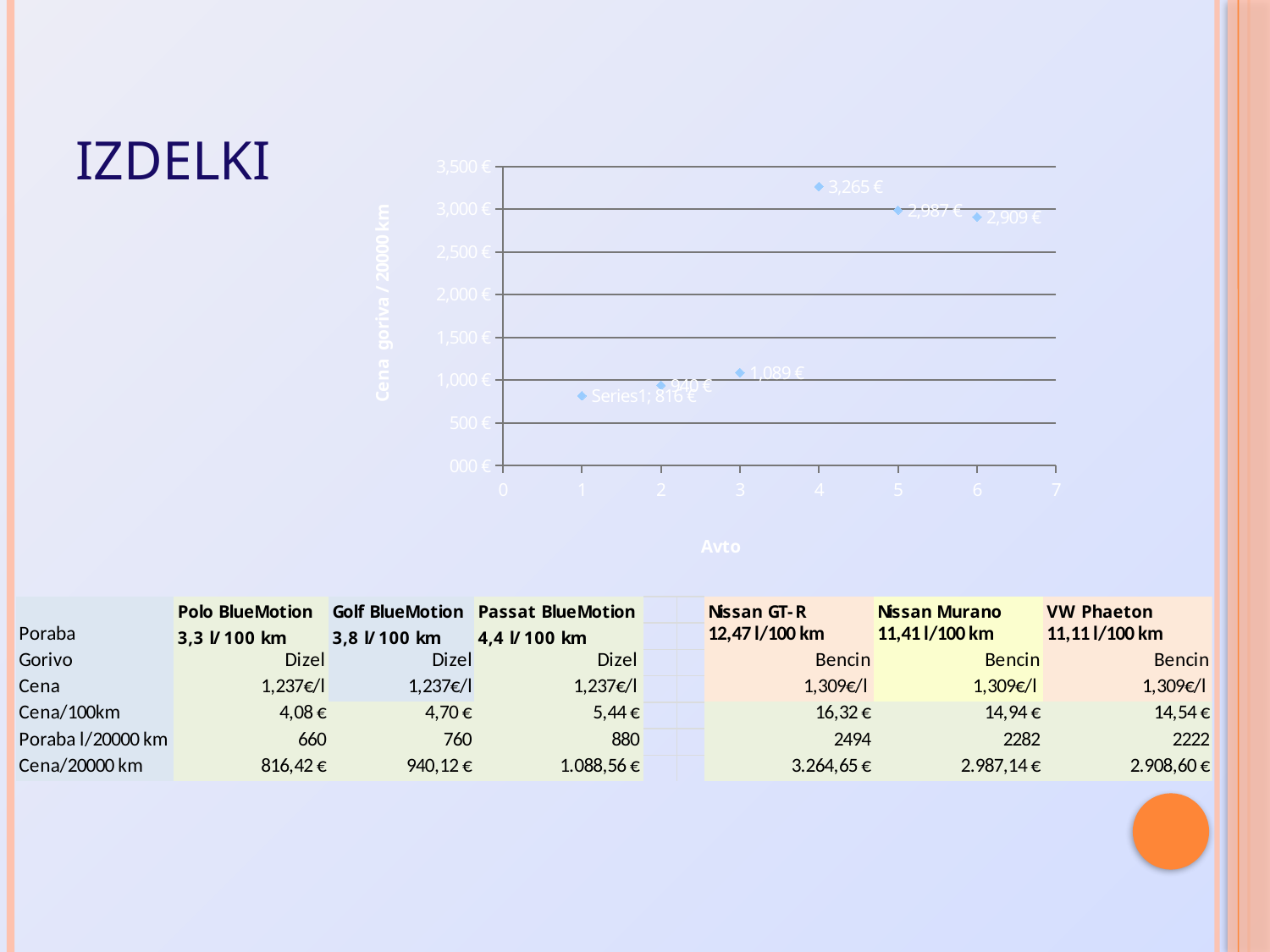
What is the data label of the point at x = 1 on the chart? 816 € What is the title of the vertical axis of the chart? Cena goriva / 20000 km What is the difference between the point at x = 4 and the point at x = 6? 356 € Is the value of the point at x = 2 greater or less than 1,000 €? less At which x position is the highest point on the chart? 4 What is the data label of the point at x = 3 on the chart? 1,089 € Which point has the larger value, the one at x = 5 or the one at x = 6? x = 5 What is the data label of the point at x = 4 on the chart? 3,265 € At which x position is the lowest point on the chart? 1 How many data points are plotted on the chart? 6 What is the data label of the point at x = 6 on the chart? 2,909 € What kind of chart is shown on the slide? scatter chart